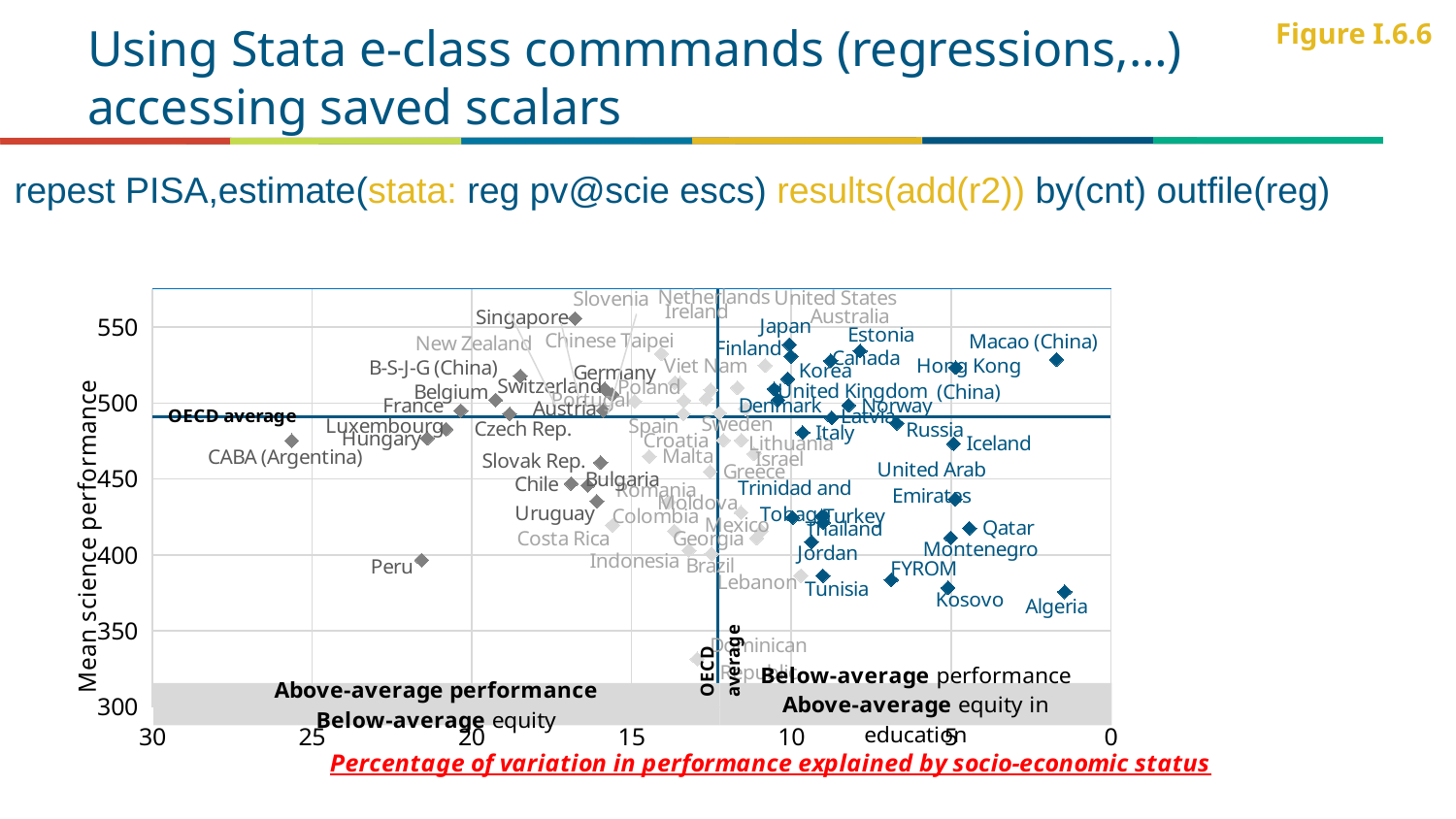
What is the label of the vertical axis of the chart? Mean science performance What kind of chart is shown on the slide? scatter plot Is the mean science performance for Macao (China) greater or less than 500? greater Is the percentage of variation explained by socio-economic status for Algeria greater or less than 5? less What is the label of the horizontal axis of the chart? Percentage of variation in performance explained by socio-economic status Is the mean science performance for Algeria greater or less than 400? less Which has a higher mean science performance, Macao (China) or Kosovo? Macao (China) Which country has the highest mean science performance in the chart? Singapore Which has a higher mean science performance, Singapore or Peru? Singapore